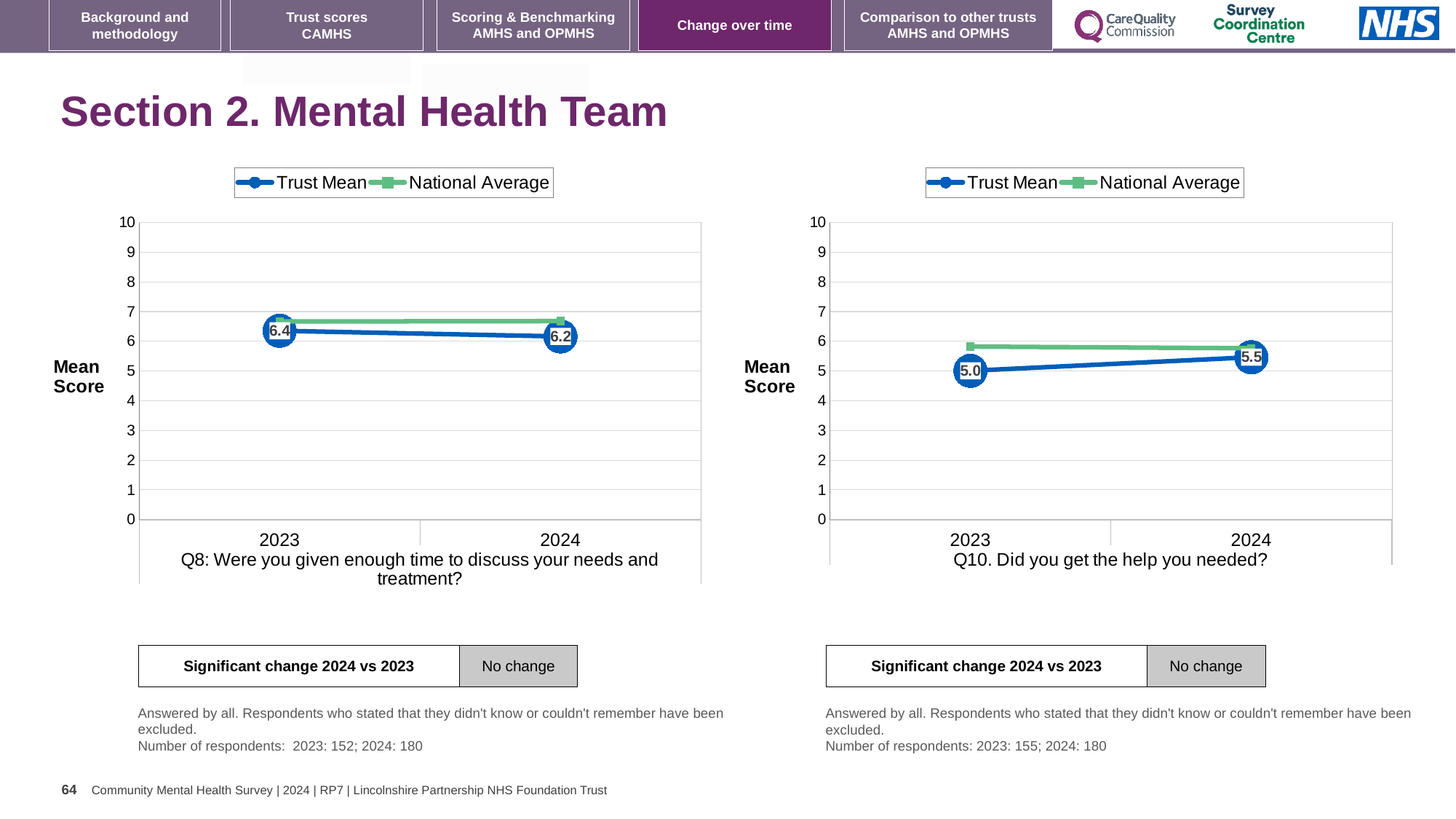
On the Q8 chart (left), what is the difference between the Trust Mean scores for 2023 and 2024? 0.2 On the Q8 chart (left), is the National Average for 2024 greater or less than 6? greater How many series does the legend of the Q10 chart (right) list? 2 On the Q10 chart (right), is the National Average for 2023 greater or less than 5? greater On the Q8 chart (left), does the Trust Mean rise or fall from 2023 to 2024? fall On the Q8 chart (left), what is the Trust Mean score for 2024? 6.2 What kind of chart is the Q8 chart (left)? line chart On the Q8 chart (left), what is the Trust Mean score for 2023? 6.4 On the Q10 chart (right), does the Trust Mean rise or fall from 2023 to 2024? rise On the Q10 chart (right), what is the Trust Mean score for 2024? 5.5 On the Q10 chart (right), what is the Trust Mean score for 2023? 5.0 On the Q10 chart (right), what is the difference between the Trust Mean scores for 2024 and 2023? 0.5